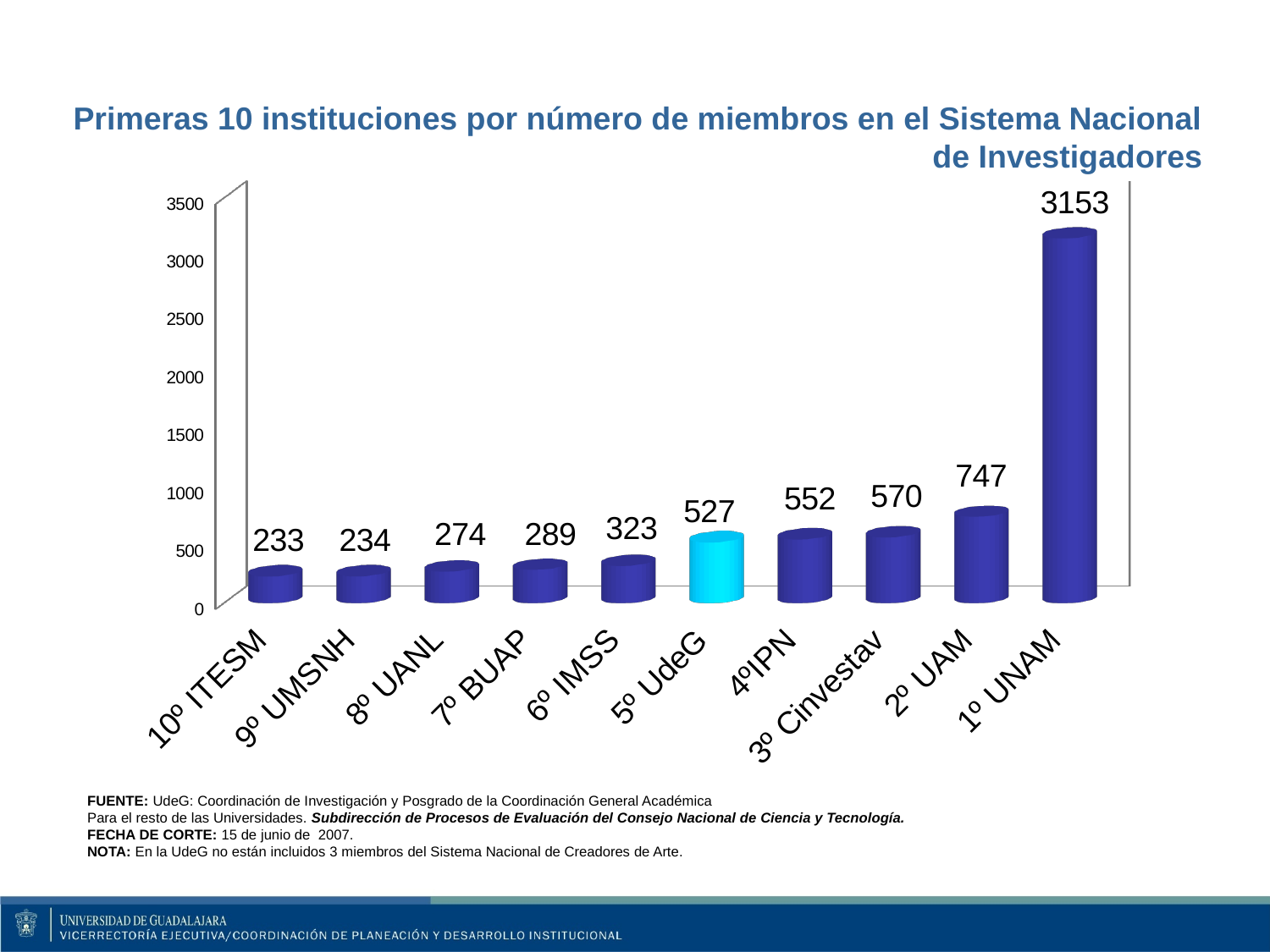
What is the value for 1º UNAM? 3153 Which institution's bar is highlighted in a different colour (light blue)? 5º UdeG Is the value for 2º UAM greater or less than 1000? less What is the difference between the values for 2º UAM and 4ºIPN? 195 Which is larger, the value for 6º IMSS or the value for 7º BUAP? 6º IMSS What is the value for 5º UdeG? 527 What is the value for 3º Cinvestav? 570 What kind of chart is shown on the slide? bar chart Which institution has the highest number of members? 1º UNAM Do the values rise or fall from left to right along the x axis? rise Which institution has the lowest number of members? 10º ITESM How many institutions are shown in the chart? 10